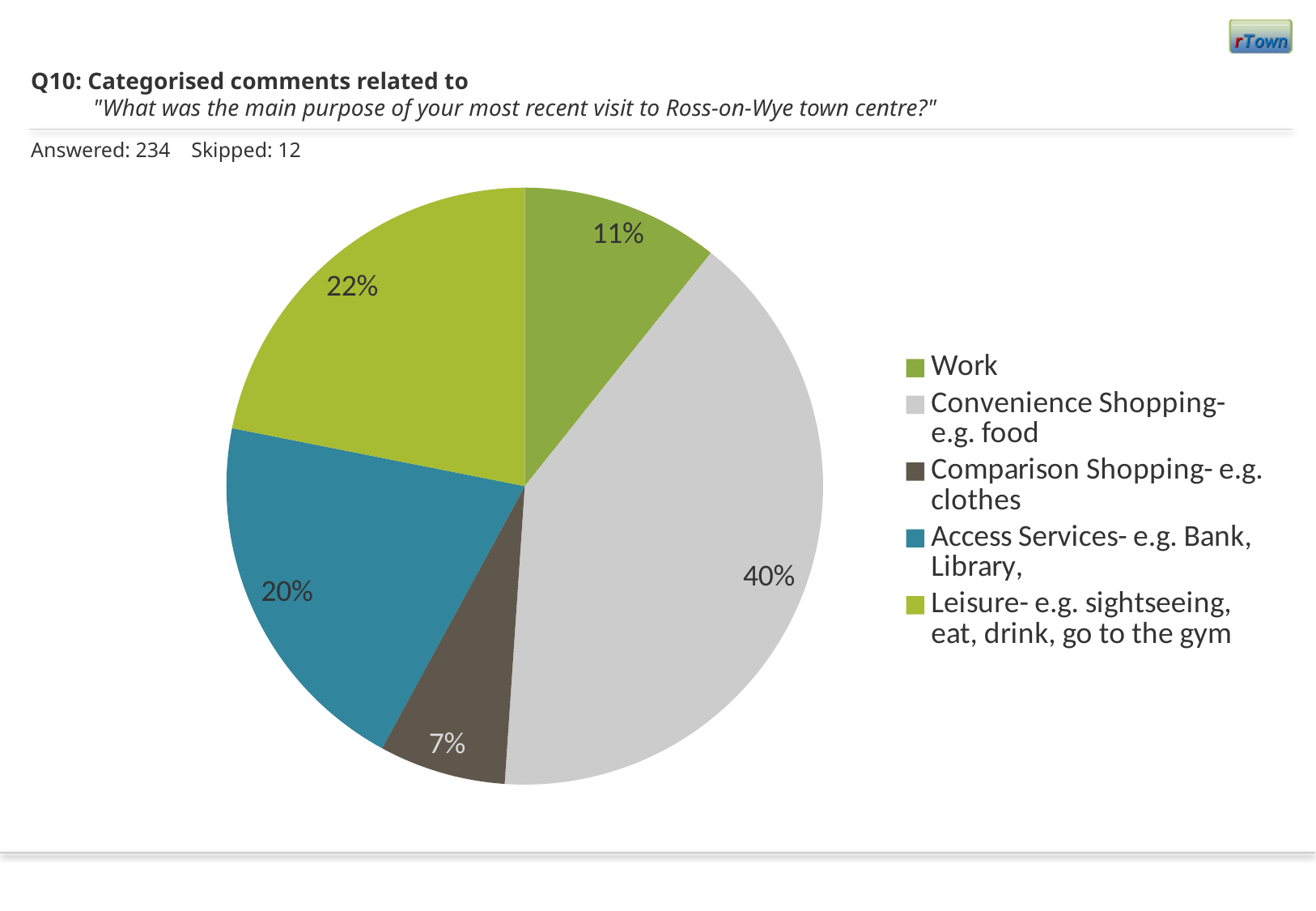
What share of the pie does Convenience Shopping- e.g. food have? 40% Which category has the largest share of the pie? Convenience Shopping- e.g. food What is the difference between the shares for Convenience Shopping- e.g. food and Leisure- e.g. sightseeing, eat, drink, go to the gym? 18% How many respondents answered the question according to the slide? 234 What is the value for Work? 11% What is the value for Leisure- e.g. sightseeing, eat, drink, go to the gym? 22% What kind of chart is shown on the slide? pie chart How many categories does the pie chart show? 5 Which category has the smallest share of the pie? Comparison Shopping- e.g. clothes What is the value for Comparison Shopping- e.g. clothes? 7% What is the value for Access Services- e.g. Bank, Library? 20% Which is larger, the share for Work or the share for Access Services- e.g. Bank, Library? Access Services- e.g. Bank, Library